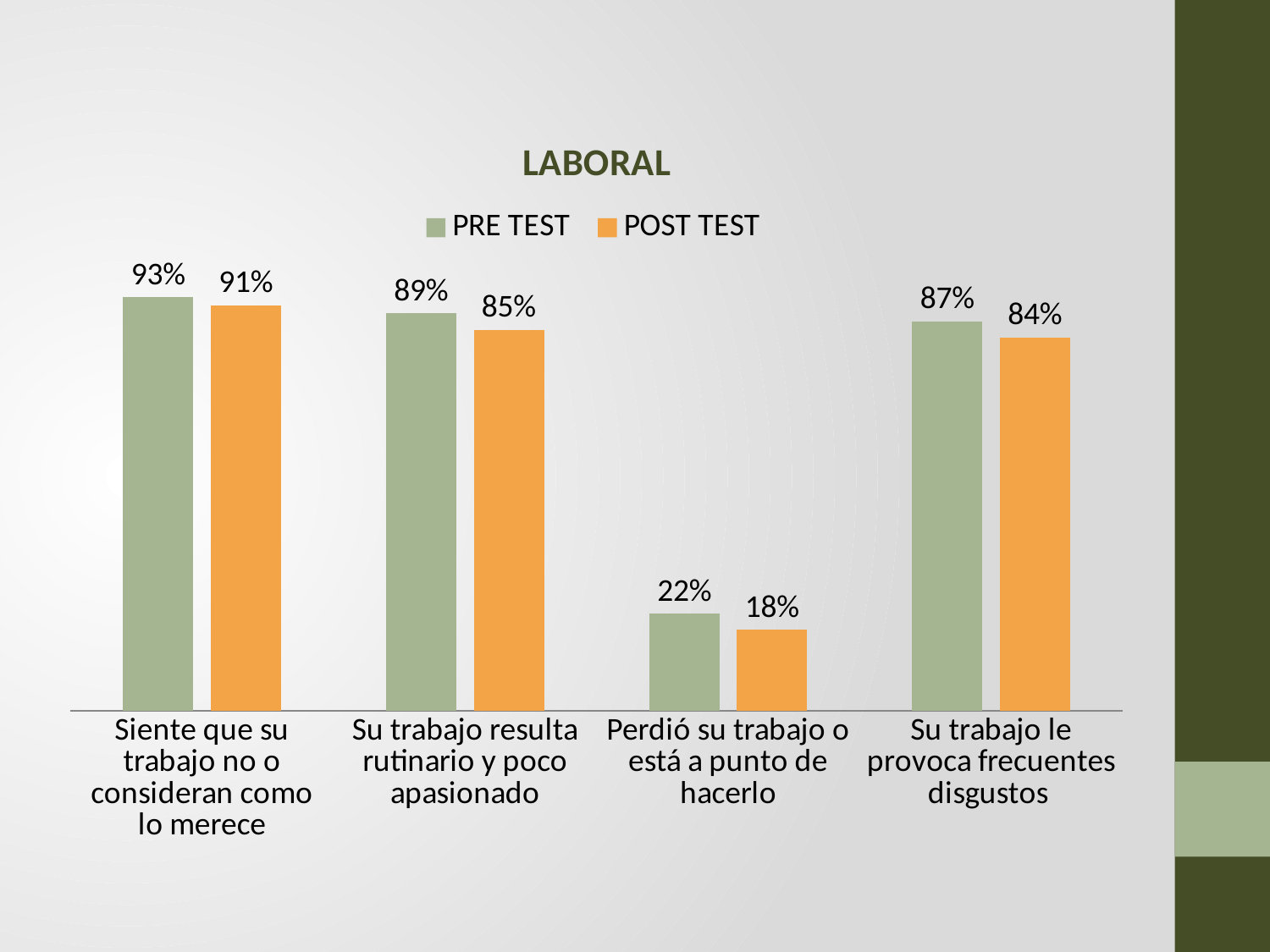
How many categories are shown on the x axis? 4 Which is larger for "Su trabajo le provoca frecuentes disgustos": the PRE TEST value or the POST TEST value? PRE TEST What is the POST TEST value for "Perdió su trabajo o está a punto de hacerlo"? 18% What is the difference between the PRE TEST and POST TEST values for "Perdió su trabajo o está a punto de hacerlo"? 4% Which category has the highest POST TEST value? Siente que su trabajo no o consideran como lo merece What is the POST TEST value for "Su trabajo le provoca frecuentes disgustos"? 84% How many series does the legend list? 2 What is the difference between the PRE TEST and POST TEST values for "Su trabajo resulta rutinario y poco apasionado"? 4% Which category has the lowest PRE TEST value? Perdió su trabajo o está a punto de hacerlo What is the PRE TEST value for "Siente que su trabajo no o consideran como lo merece"? 93% What is the title of the chart? LABORAL What kind of chart is shown on the slide? Bar chart